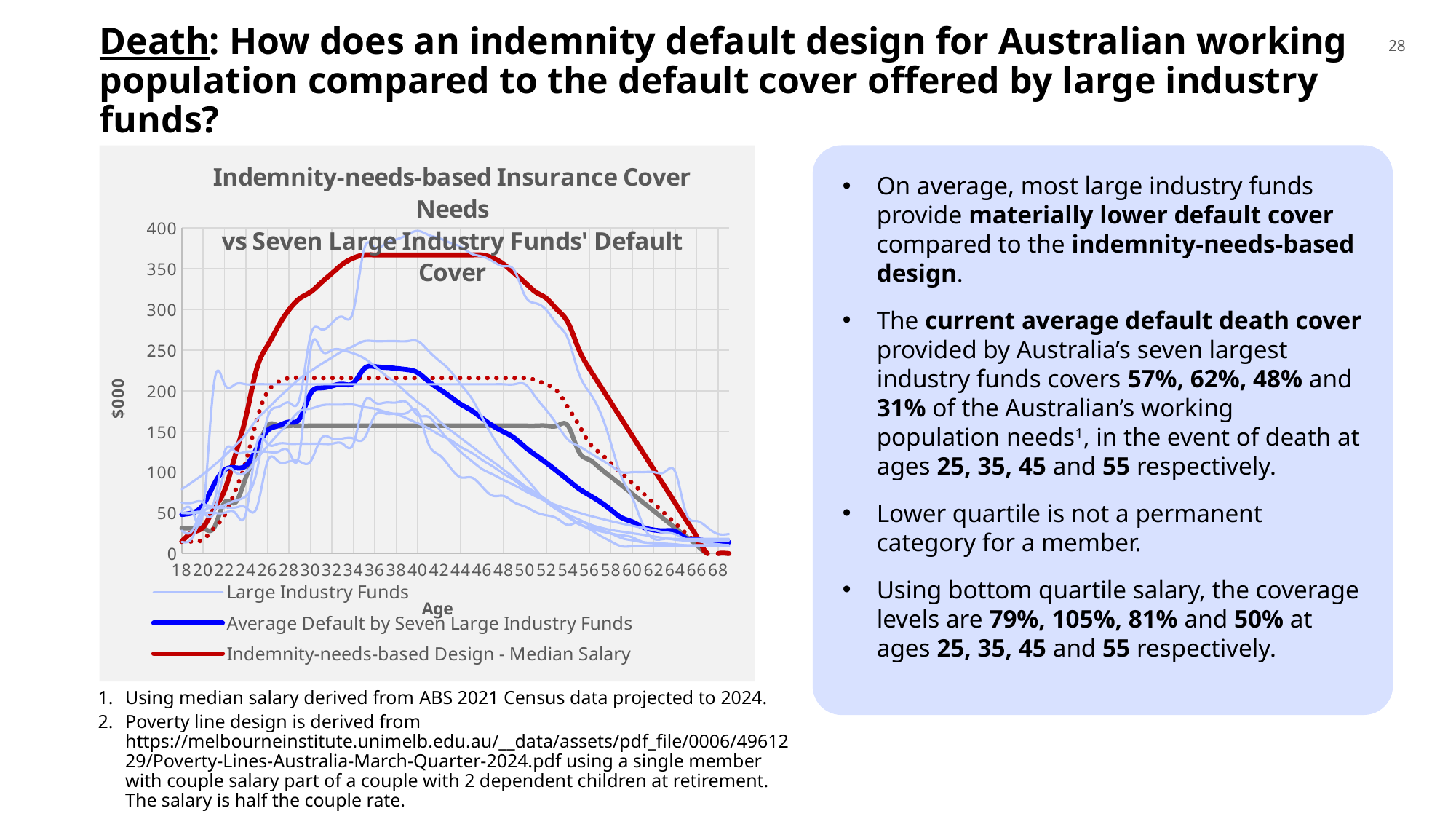
Is the value of the Indemnity-needs-based Design - Median Salary line at age 40 greater or less than 350? greater Does the Indemnity-needs-based Design - Median Salary line rise or fall between ages 18 and 34? Rise What is the label on the horizontal axis of the chart? Age At age 40, which is higher: the Indemnity-needs-based Design - Median Salary line or the Average Default by Seven Large Industry Funds line? Indemnity-needs-based Design - Median Salary Is the value of the Average Default by Seven Large Industry Funds line at age 52 greater or less than 150? less What is the label on the vertical axis of the chart? $000 How many series does the chart's legend list? 3 Is the value of the Average Default by Seven Large Industry Funds line at age 60 greater or less than 50? less What kind of chart is shown on the slide? Line chart Does the Indemnity-needs-based Design - Median Salary line rise or fall between ages 50 and 68? Fall